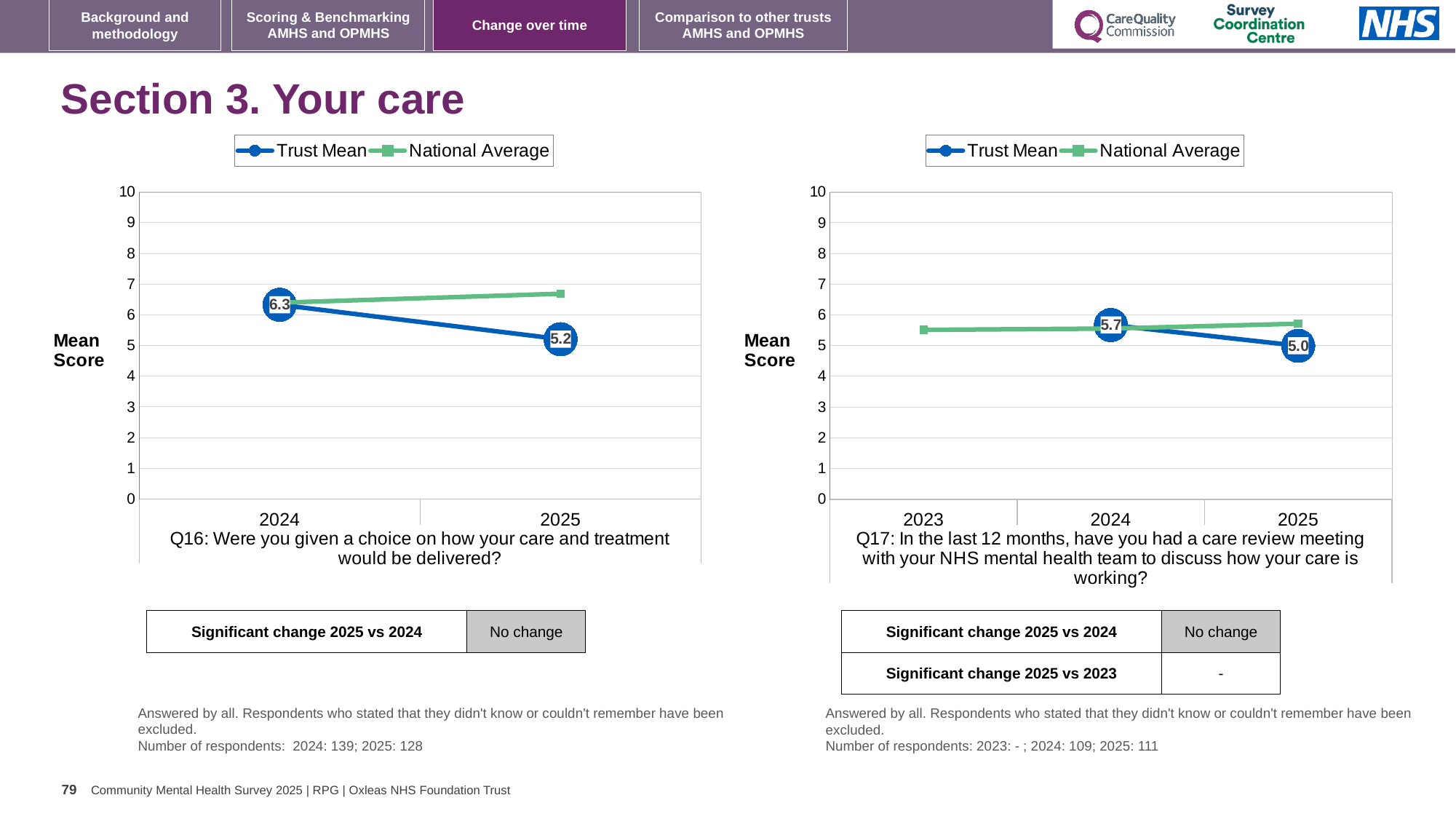
In the Q16 chart on the left, what is the Trust Mean score for 2025? 5.2 In the Q16 chart on the left, what is the Trust Mean score for 2024? 6.3 In the Q17 chart on the right, what is the difference between the Trust Mean for 2024 and 2025? 0.7 In the Q17 chart on the right, which is larger in 2025, the Trust Mean or the National Average? National Average In the Q16 chart on the left, does the Trust Mean rise or fall from 2024 to 2025? fall In the Q16 chart on the left, is the National Average for 2025 greater or less than 6? greater In the Q17 chart on the right, what is the Trust Mean score for 2024? 5.7 In the Q17 chart on the right, what is the Trust Mean score for 2025? 5.0 How many series does the legend of the Q16 chart on the left list? 2 How many years are shown on the x axis of the Q17 chart on the right? 3 In the Q16 chart on the left, by how much did the Trust Mean fall from 2024 to 2025? 1.1 What type of chart is used for Q16 on the left? line chart